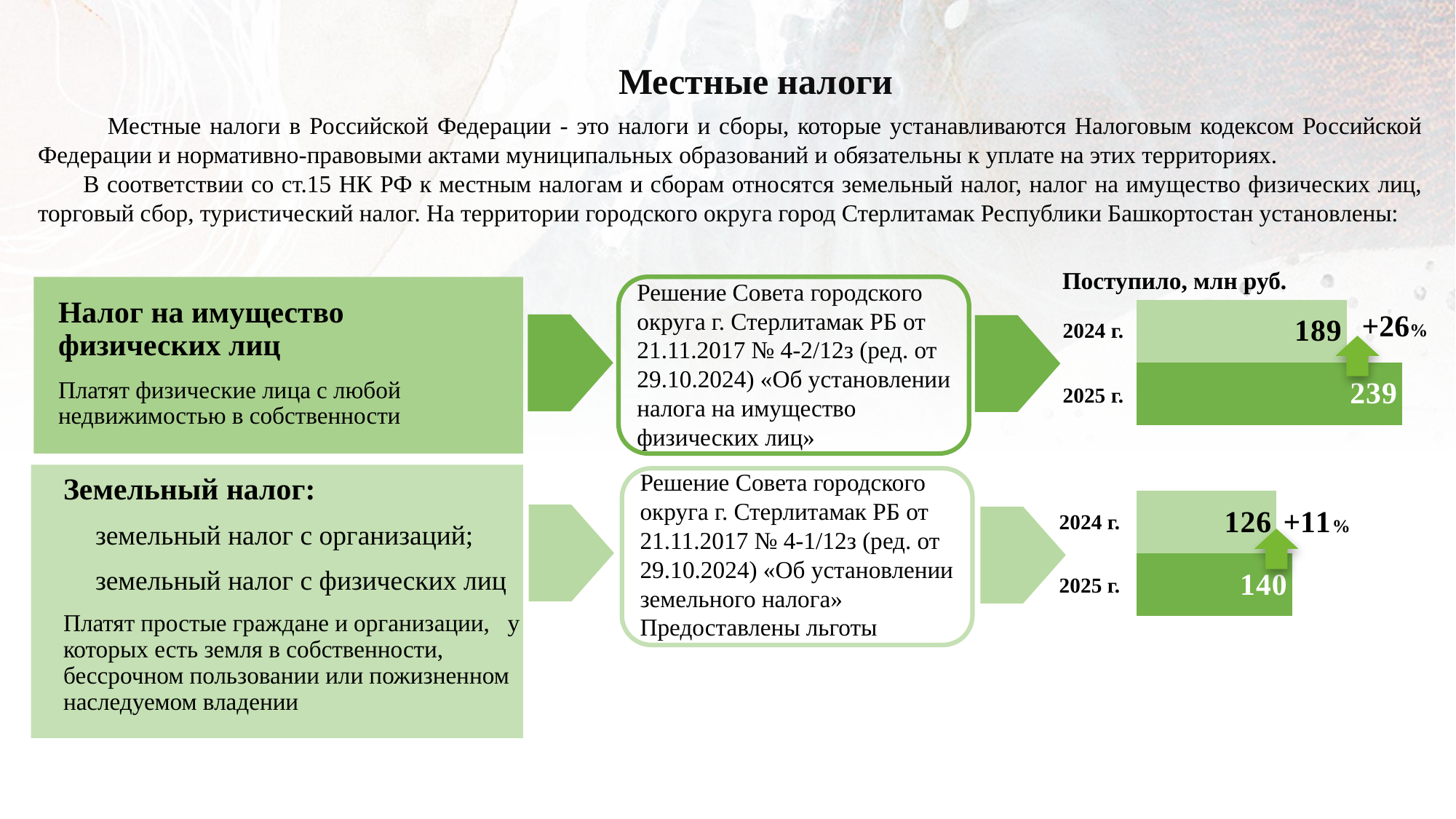
In the bar chart for the property tax on individuals (upper chart), what was the amount received in 2025? 239 How many years (bars) are shown in the upper chart for the property tax on individuals? 2 What percentage change is shown next to the lower chart (land tax)? +11% What percentage change is shown next to the upper chart (property tax on individuals)? +26% In the upper chart (property tax on individuals), which year has the higher value, 2024 or 2025? 2025 In the lower chart (land tax), by how much did receipts increase from 2024 to 2025, in млн руб.? 14 In the bar chart for the land tax (lower chart), what was the amount received in 2024? 126 In the bar chart for the land tax (lower chart), what was the amount received in 2025? 140 What type of chart is used to show the receipts for the land tax (lower chart)? bar chart In the lower chart (land tax), which year has the lower value? 2024 In the upper chart (property tax on individuals), by how much did receipts increase from 2024 to 2025, in млн руб.? 50 In the bar chart for the property tax on individuals (upper chart), what was the amount received in 2024? 189